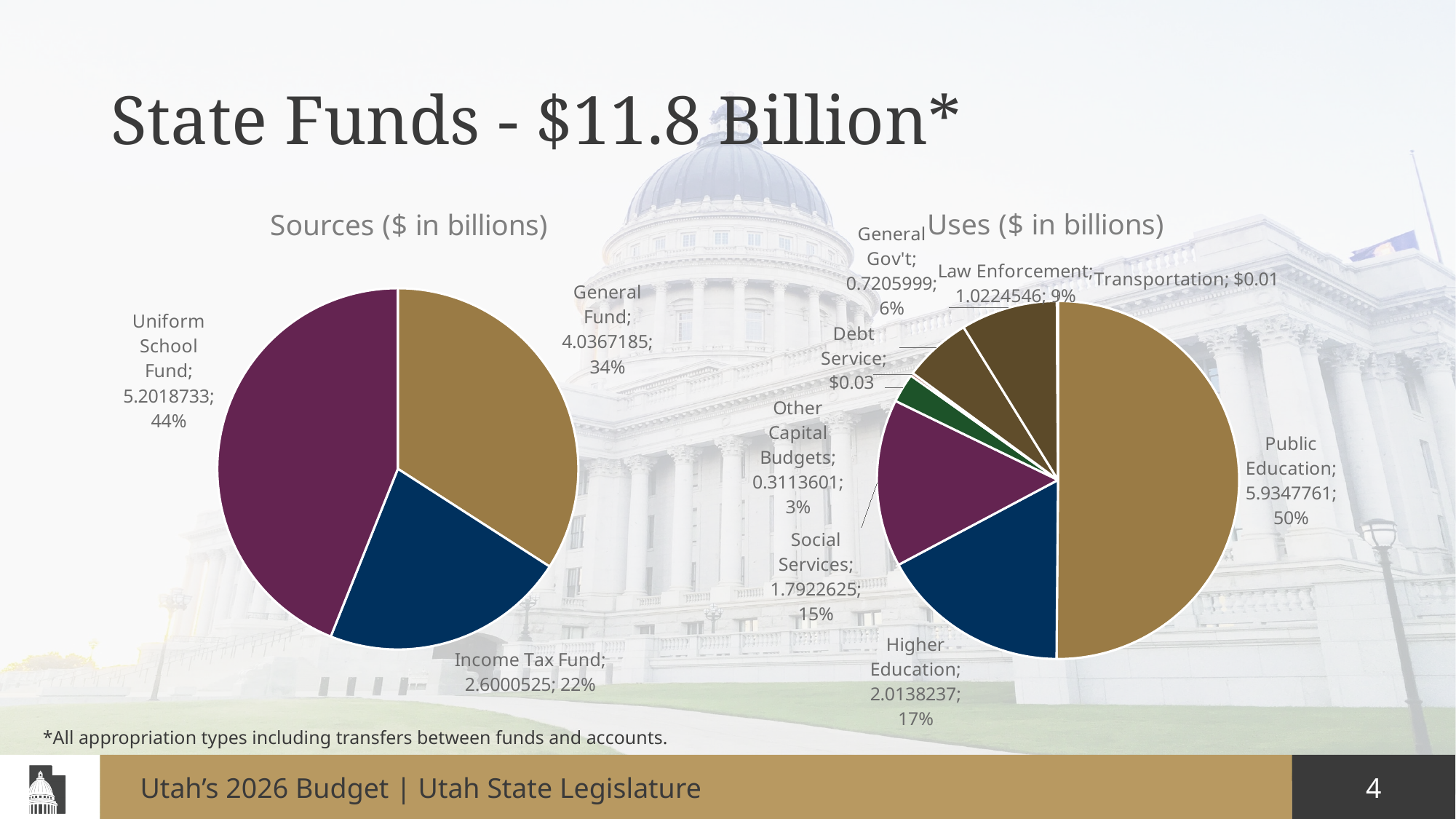
On the Uses ($ in billions) chart, what value is shown for Transportation? $0.01 On the Uses ($ in billions) chart, what value is shown for Public Education? 5.9347761 How many slices does the Sources ($ in billions) pie chart have? 3 What type of chart is used for Sources ($ in billions)? Pie chart How many slices does the Uses ($ in billions) pie chart have? 8 On the Uses ($ in billions) chart, what share of the pie is Social Services? 15% On the Sources ($ in billions) chart, what value is shown for the Uniform School Fund? 5.2018733 On the Sources ($ in billions) chart, which source is the smallest? Income Tax Fund On the Sources ($ in billions) chart, what is the difference in percentage points between the Uniform School Fund and the Income Tax Fund shares? 22 On the Uses ($ in billions) chart, which use is the largest? Public Education On the Uses ($ in billions) chart, which is larger, Higher Education or Law Enforcement? Higher Education On the Sources ($ in billions) chart, what share of the pie is the General Fund? 34%